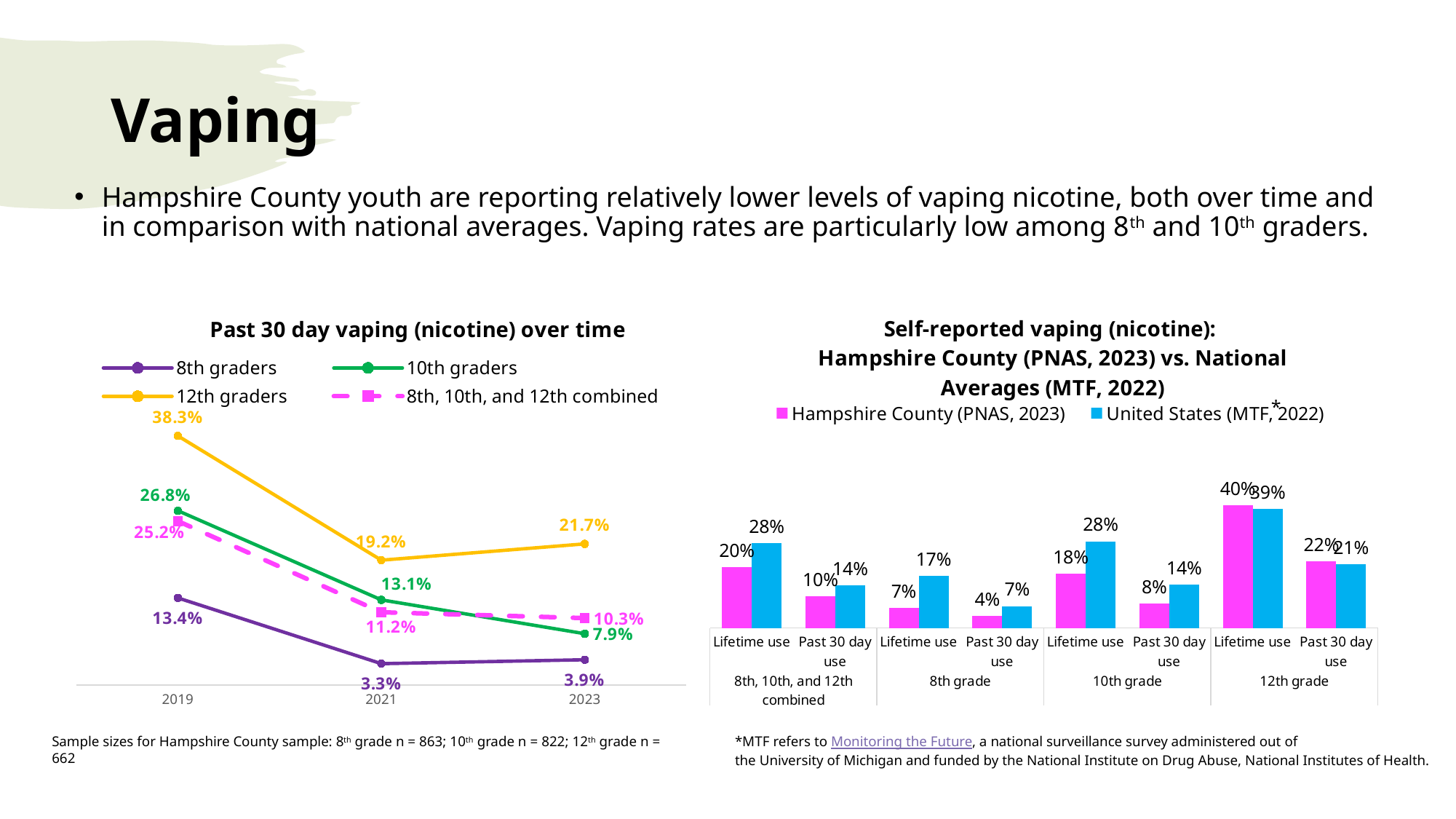
In the 'Past 30 day vaping (nicotine) over time' chart, what was the value for 8th graders in 2021? 3.3% In the 'Past 30 day vaping (nicotine) over time' chart, how many series does the legend list? 4 In the 'Self-reported vaping (nicotine)' chart on the right, what is the Hampshire County value for lifetime use among 12th grade? 40% In the 'Past 30 day vaping (nicotine) over time' chart, what was the value for 10th graders in 2023? 7.9% In the 'Self-reported vaping (nicotine)' chart on the right, what is the difference between the United States and Hampshire County values for lifetime use among 10th grade? 10% In the 'Past 30 day vaping (nicotine) over time' chart, what is the difference between the 12th graders' values in 2019 and 2023? 16.6% In the 'Past 30 day vaping (nicotine) over time' chart, what was the value for 12th graders in 2019? 38.3% In the 'Self-reported vaping (nicotine)' chart on the right, what is the United States value for past 30 day use among 8th grade? 7% What kind of chart is the 'Self-reported vaping (nicotine)' chart on the right? bar chart What kind of chart is 'Past 30 day vaping (nicotine) over time'? line chart In the 'Past 30 day vaping (nicotine) over time' chart, did the 10th graders' value rise or fall from 2019 to 2023? fall In the 'Past 30 day vaping (nicotine) over time' chart, which grade had the highest value in 2023? 12th graders